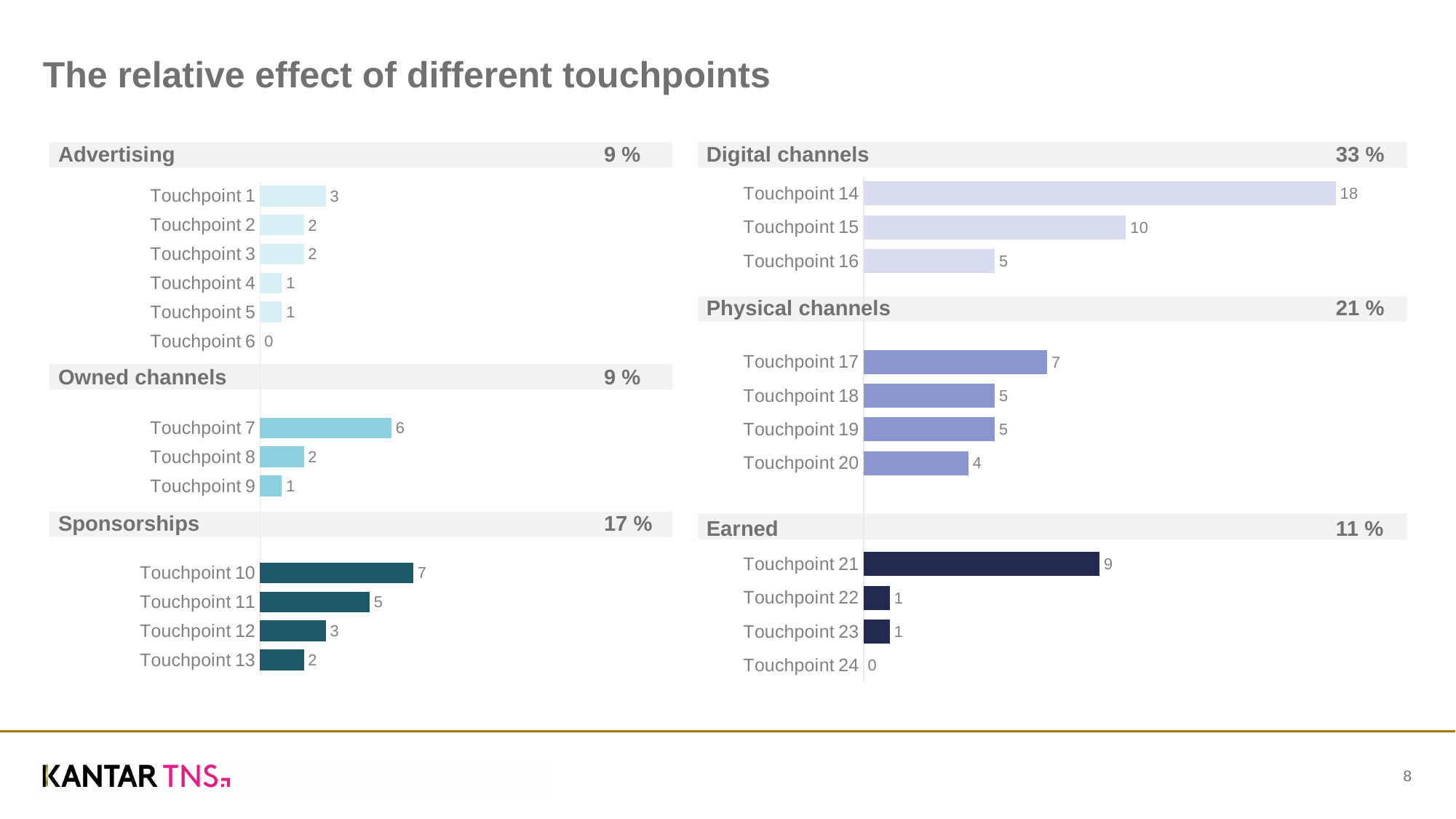
How many touchpoints are plotted in the Owned channels chart? 3 In the Earned chart, what is the value for Touchpoint 24? 0 In the Physical channels chart, what is the difference between the values for Touchpoint 17 and Touchpoint 20? 3 In the Digital channels chart, which touchpoint has the highest value? Touchpoint 14 What percentage is shown in the header of the Digital channels section? 33 % In the Digital channels chart, what is the value for Touchpoint 15? 10 How many touchpoints are plotted in the Physical channels chart? 4 In the Advertising chart, what is the value for Touchpoint 1? 3 What kind of chart is used to show the touchpoints on this slide? Bar chart In the Sponsorships chart, which touchpoint has the lowest value? Touchpoint 13 In the Earned chart, which is larger, the value for Touchpoint 21 or Touchpoint 22? Touchpoint 21 In the Sponsorships chart, do the values rise or fall from Touchpoint 10 to Touchpoint 13? Fall